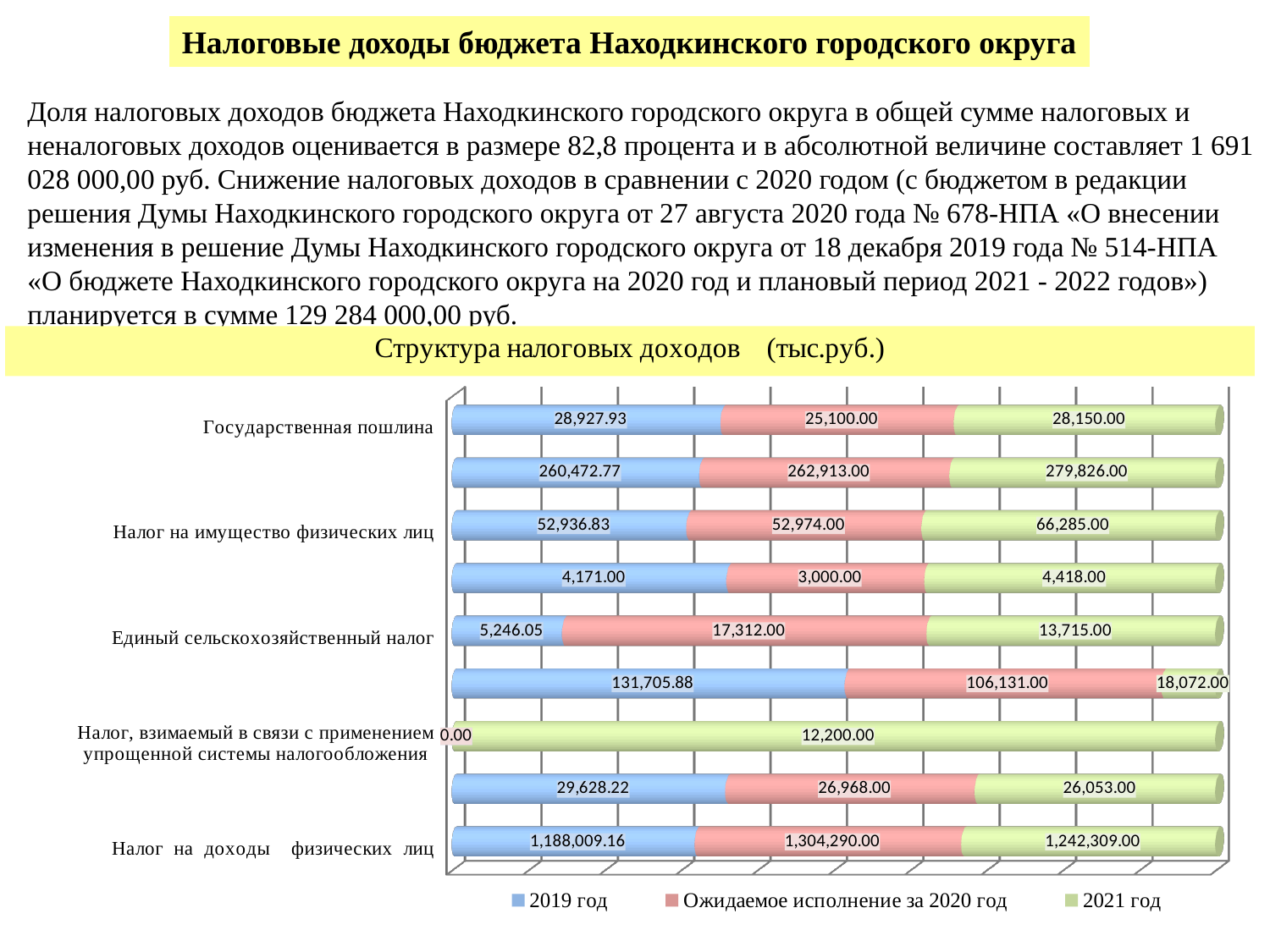
For Налог на доходы физических лиц, which series has the highest value? Ожидаемое исполнение за 2020 год What is the 2021 год value for Единый сельскохозяйственный налог? 13,715.00 What is the 2019 год value for Налог на доходы физических лиц? 1,188,009.16 What is the difference between the 2019 год and Ожидаемое исполнение за 2020 год values for Государственная пошлина? 3,827.93 What is the 2019 год value for Налог, взимаемый в связи с применением упрощенной системы налогообложения? 0.00 For Единый сельскохозяйственный налог, which series has the lowest value? 2019 год What is the difference between the 2021 год and Ожидаемое исполнение за 2020 год values for Налог на имущество физических лиц? 13,311.00 What is the Ожидаемое исполнение за 2020 год value for Налог на имущество физических лиц? 52,974.00 What kind of chart is shown on the slide? Stacked bar chart What is the 2019 год value for Государственная пошлина? 28,927.93 How many series does the legend list? 3 For Единый сельскохозяйственный налог, which is larger: the Ожидаемое исполнение за 2020 год value or the 2021 год value? Ожидаемое исполнение за 2020 год